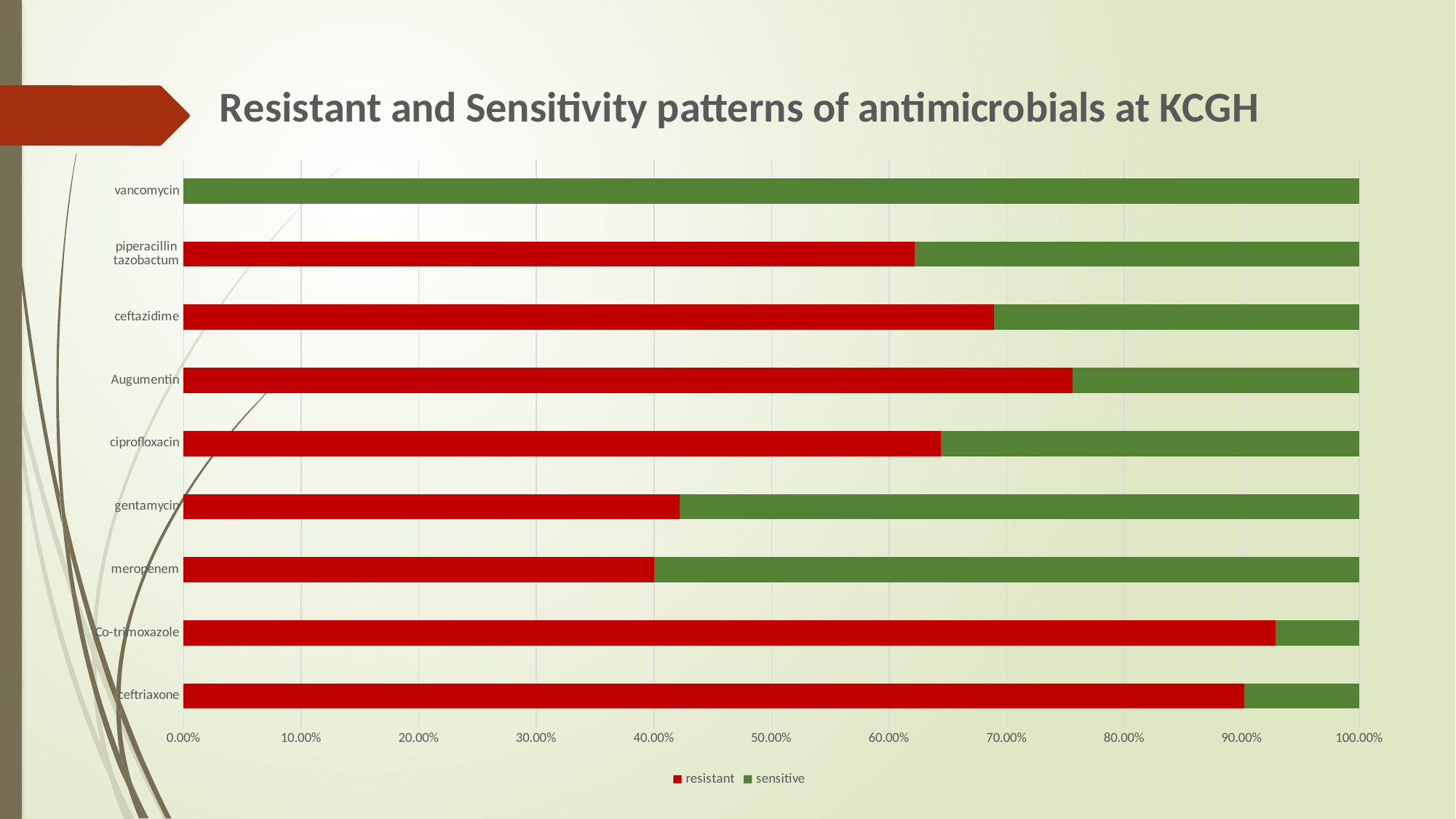
How many antimicrobials are listed on the chart? 9 Is the resistant share for Augumentin greater or less than 70.00%? greater Is the resistant share for piperacillin tazobactum greater or less than 60.00%? greater Is the resistant share for gentamycin greater or less than 40.00%? greater Which has the larger resistant share, Augumentin or ceftazidime? Augumentin Which antimicrobial has the lowest resistant share? vancomycin What is the sensitive share for vancomycin? 100.00% How many series does the legend list? 2 Which colour represents the sensitive series in the chart? green What kind of chart is shown on the slide? bar chart Which antimicrobial has the highest resistant share? Co-trimoxazole